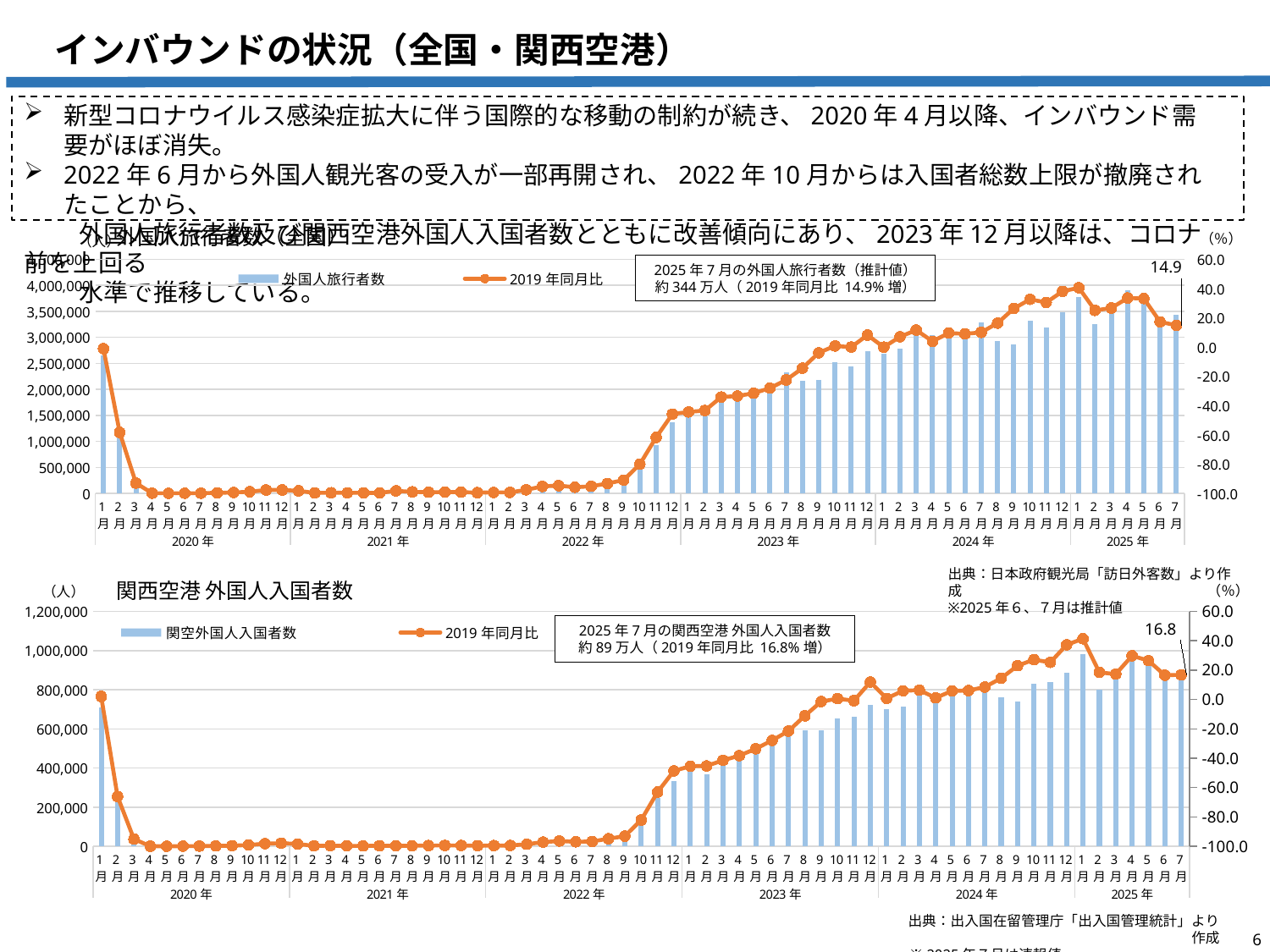
In the top chart (外国人旅行者数（全国）), which is larger: the bar for 2020年1月 or the bar for 2025年1月? 2025年1月 In the bottom chart (関西空港 外国人入国者数), what is the legend label for the bar series? 関空外国人入国者数 How many series does the legend of the top chart (外国人旅行者数（全国）) list? 2 In the bottom chart (関西空港 外国人入国者数), do the bar values generally rise or fall from 2022年 through 2025年? rise In the bottom chart (関西空港 外国人入国者数), is the bar value for 2021年1月 greater or less than 200,000? less In the bottom chart (関西空港 外国人入国者数), which is larger: the bar for 2020年1月 or the bar for 2025年1月? 2025年1月 In the top chart (外国人旅行者数（全国）), what is the 2019年同月比 value shown for 2025年7月? 14.9 What kind of chart is the bottom chart (関西空港 外国人入国者数)? Combined bar and line chart In the top chart (外国人旅行者数（全国）), is the bar value for 2025年7月 greater or less than 3,000,000? greater In the bottom chart (関西空港 外国人入国者数), what is the 2019年同月比 value shown for 2025年7月? 16.8 In the bottom chart (関西空港 外国人入国者数), is the bar value for 2025年7月 greater or less than 800,000? greater How many series does the legend of the bottom chart (関西空港 外国人入国者数) list? 2